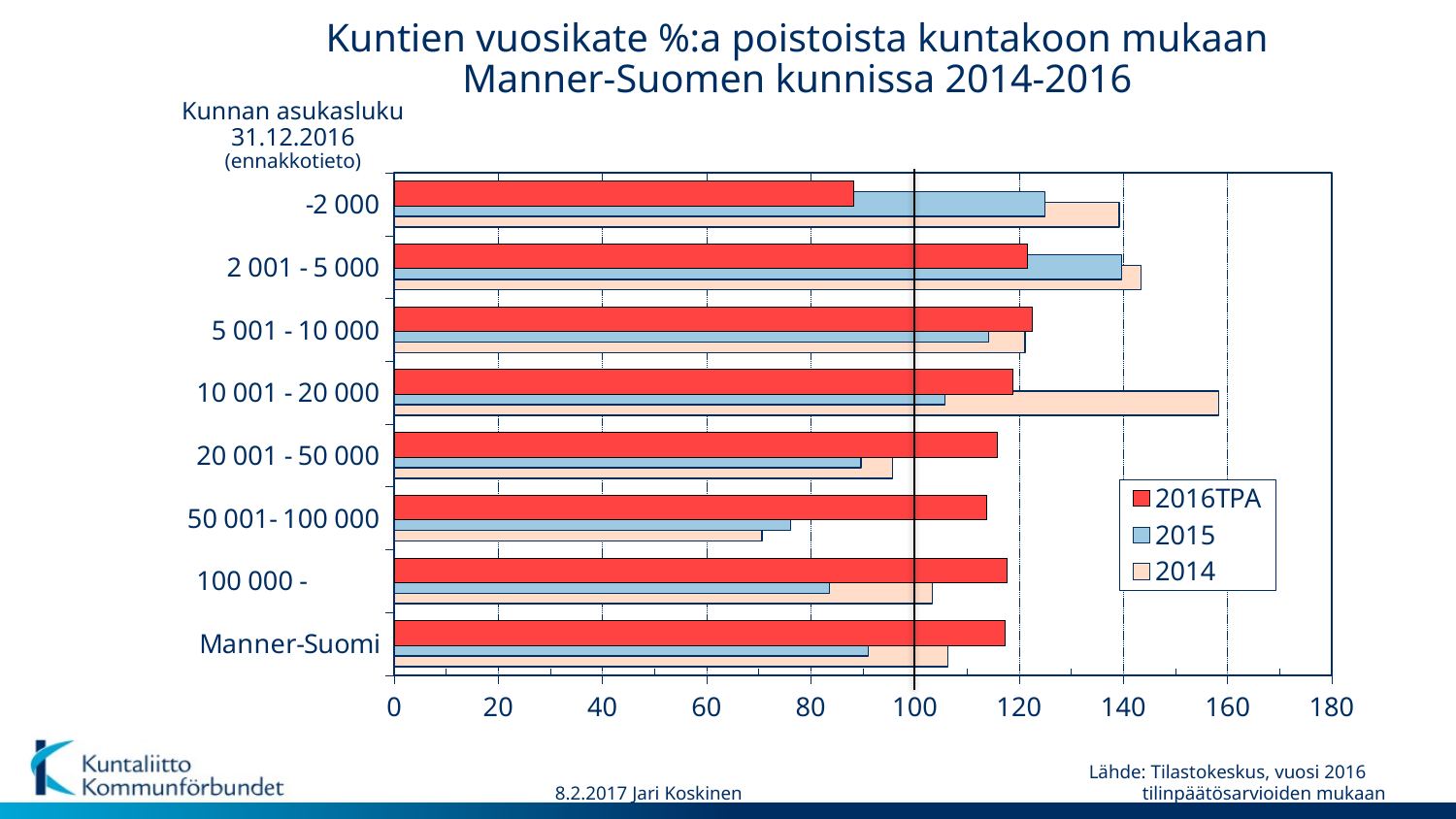
Is the 2016TPA value for -2 000 greater or less than 100? less Is the 2014 value for 10 001 - 20 000 greater or less than 140? greater Which category has the highest 2015 value? 2 001 - 5 000 Which category has the lowest 2015 value? 50 001- 100 000 For the -2 000 category, which is larger: the 2015 value or the 2016TPA value? 2015 Is the 2014 value for 50 001- 100 000 greater or less than 80? less Which category has the highest 2014 value? 10 001 - 20 000 How many categories (municipality size groups, including Manner-Suomi) are shown on the vertical axis? 8 Which category has the lowest 2016TPA value? -2 000 What are the three series names listed in the legend? 2016TPA, 2015, 2014 What kind of chart is shown on the slide? bar chart How many series does the legend list? 3